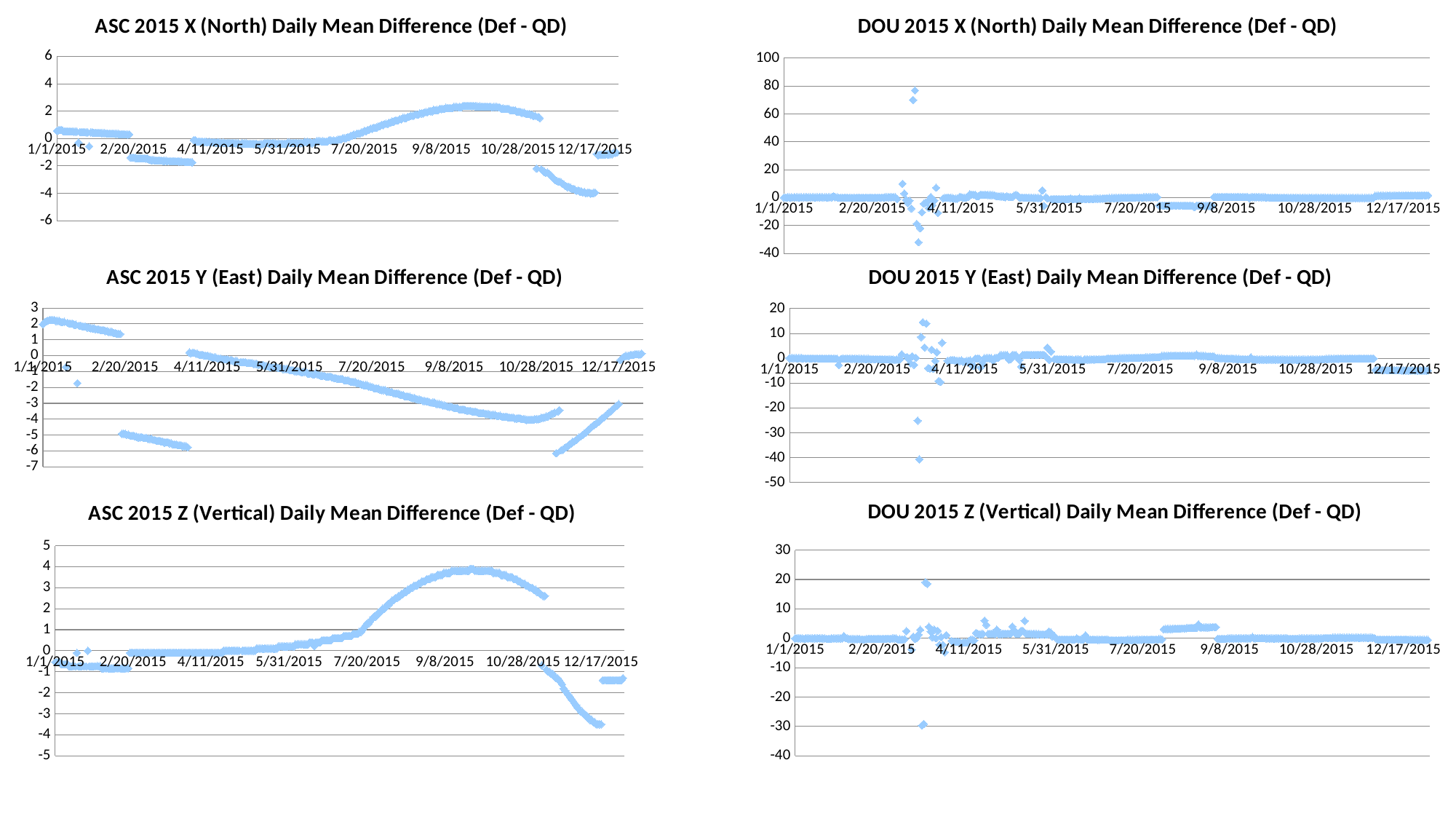
What kind of chart is 'ASC 2015 X (North) Daily Mean Difference (Def - QD)'? scatter chart In the 'DOU 2015 X (North) Daily Mean Difference (Def - QD)' chart, is the highest outlier point greater or less than 60? greater In the 'DOU 2015 Z (Vertical) Daily Mean Difference (Def - QD)' chart, is the lowest outlier point greater or less than -20? less What is the highest value shown on the y axis of the 'DOU 2015 X (North) Daily Mean Difference (Def - QD)' chart? 100 In the 'DOU 2015 Z (Vertical) Daily Mean Difference (Def - QD)' chart, is the highest outlier point greater or less than 10? greater In the 'ASC 2015 Z (Vertical) Daily Mean Difference (Def - QD)' chart, do the values rise or fall between 5/31/2015 and 9/8/2015? rise How many charts are shown on the slide? 6 In the 'ASC 2015 Y (East) Daily Mean Difference (Def - QD)' chart, do the values rise or fall between 5/31/2015 and 9/8/2015? fall